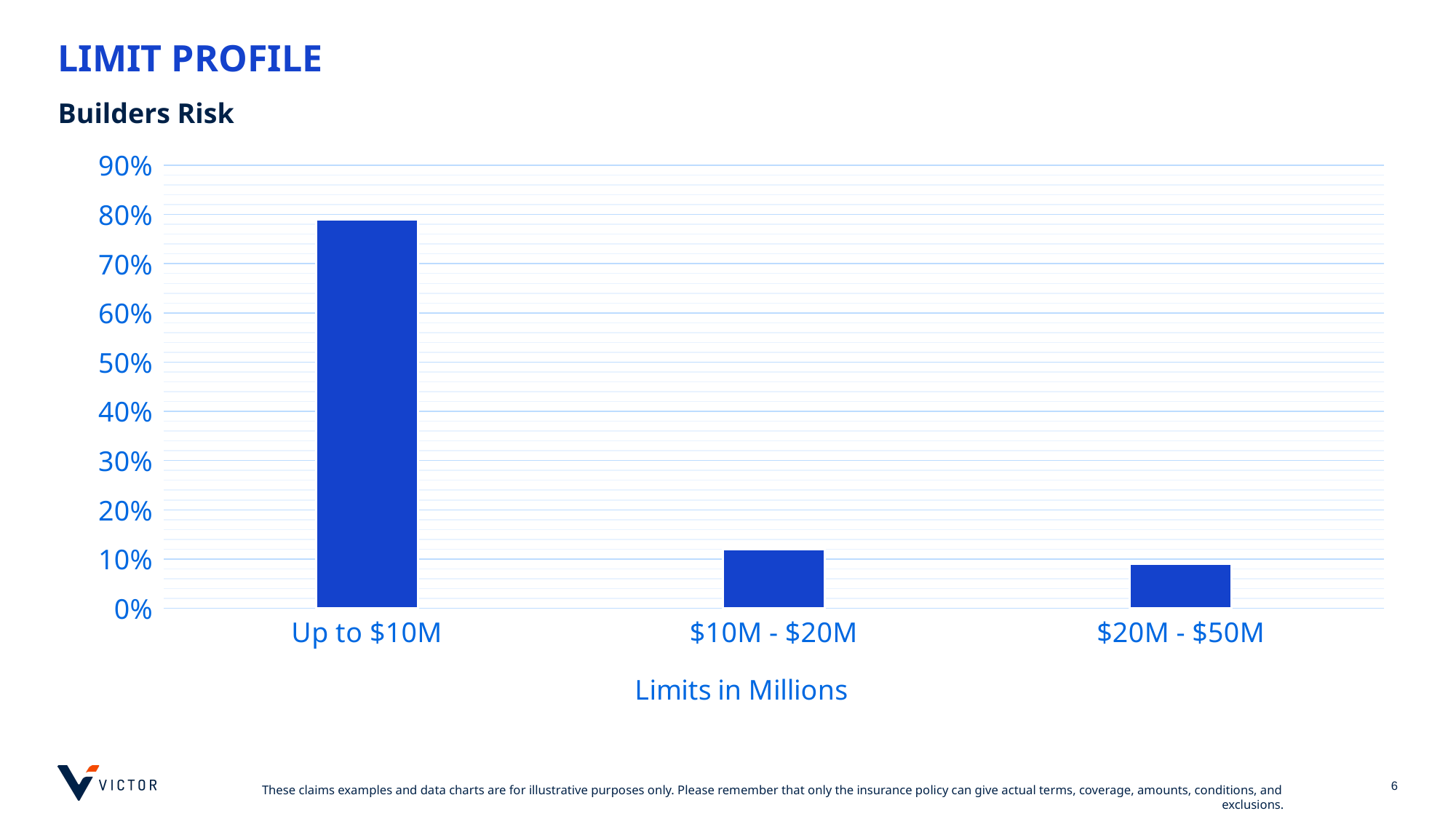
Is the value for Up to $10M greater or less than 80%? less Do the values rise or fall moving from left to right along the x axis? fall What kind of chart is shown on the slide? bar chart Which limit category has the lowest value? $20M - $50M Which limit category has the highest value? Up to $10M Is the value for $10M - $20M greater or less than 10%? greater How many limit categories are shown on the x axis? 3 What is the title of the x axis? Limits in Millions Which is larger, the value for $10M - $20M or the value for $20M - $50M? $10M - $20M Is the value for Up to $10M greater or less than 70%? greater What is the highest value shown on the y axis? 90%